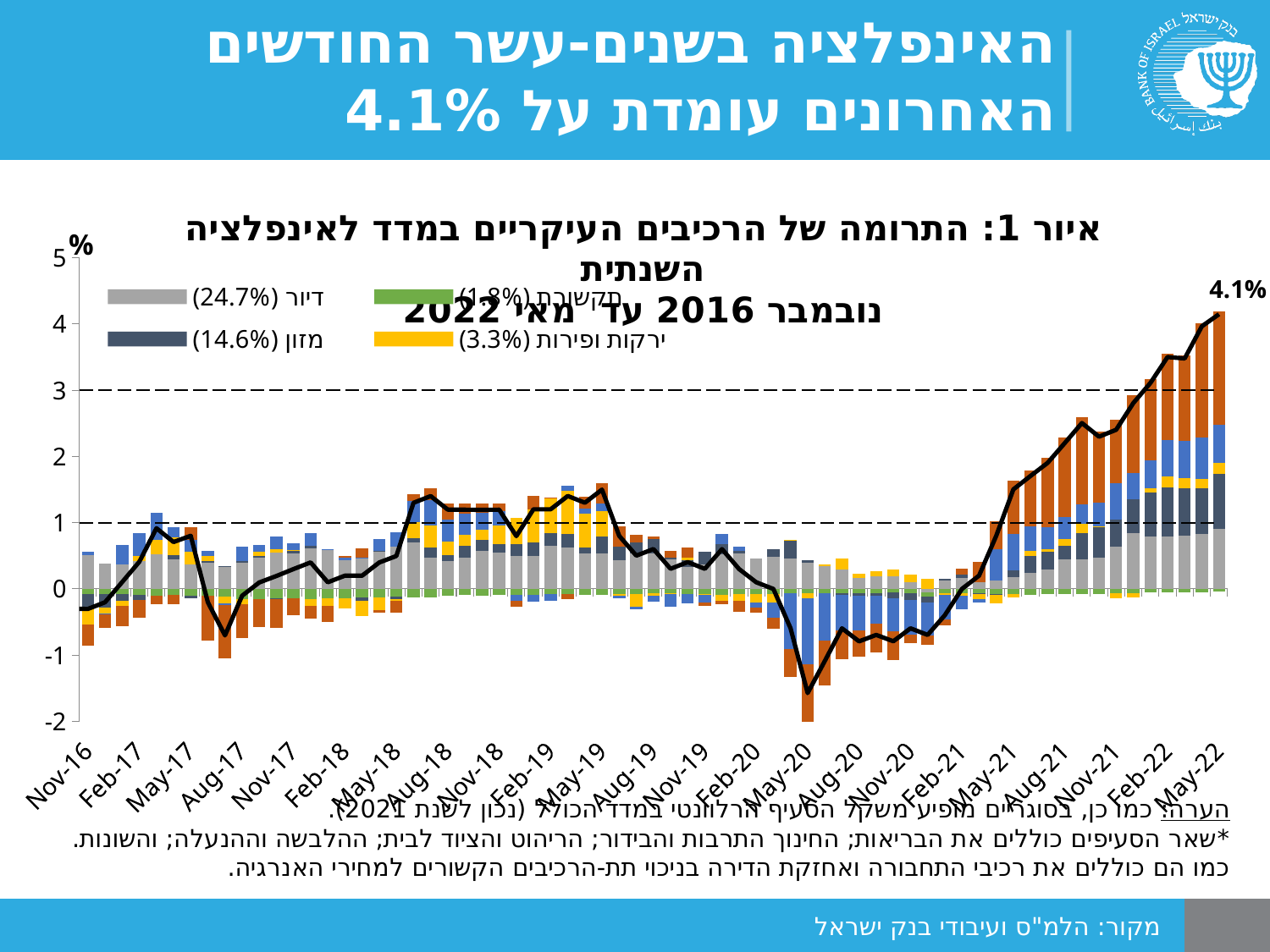
Is the line value at Nov-20 greater or less than 0? less Is the line value at Feb-22 greater or less than 3? greater Is the line value at Aug-18 greater or less than 1? greater What kind of chart is shown on the slide? Stacked bar chart with a line overlay What percentage is shown in the legend next to דיור? 24.7% Does the line rise or fall between Feb-21 and May-22? rise At which x-axis label does the line reach its highest value? May-22 How many x-axis labels are shown on the chart? 23 What percentage is shown in the legend next to מזון? 14.6% Which has the larger line value, Nov-16 or May-22? May-22 What value is printed as the data label at the end of the line (May-22)? 4.1%